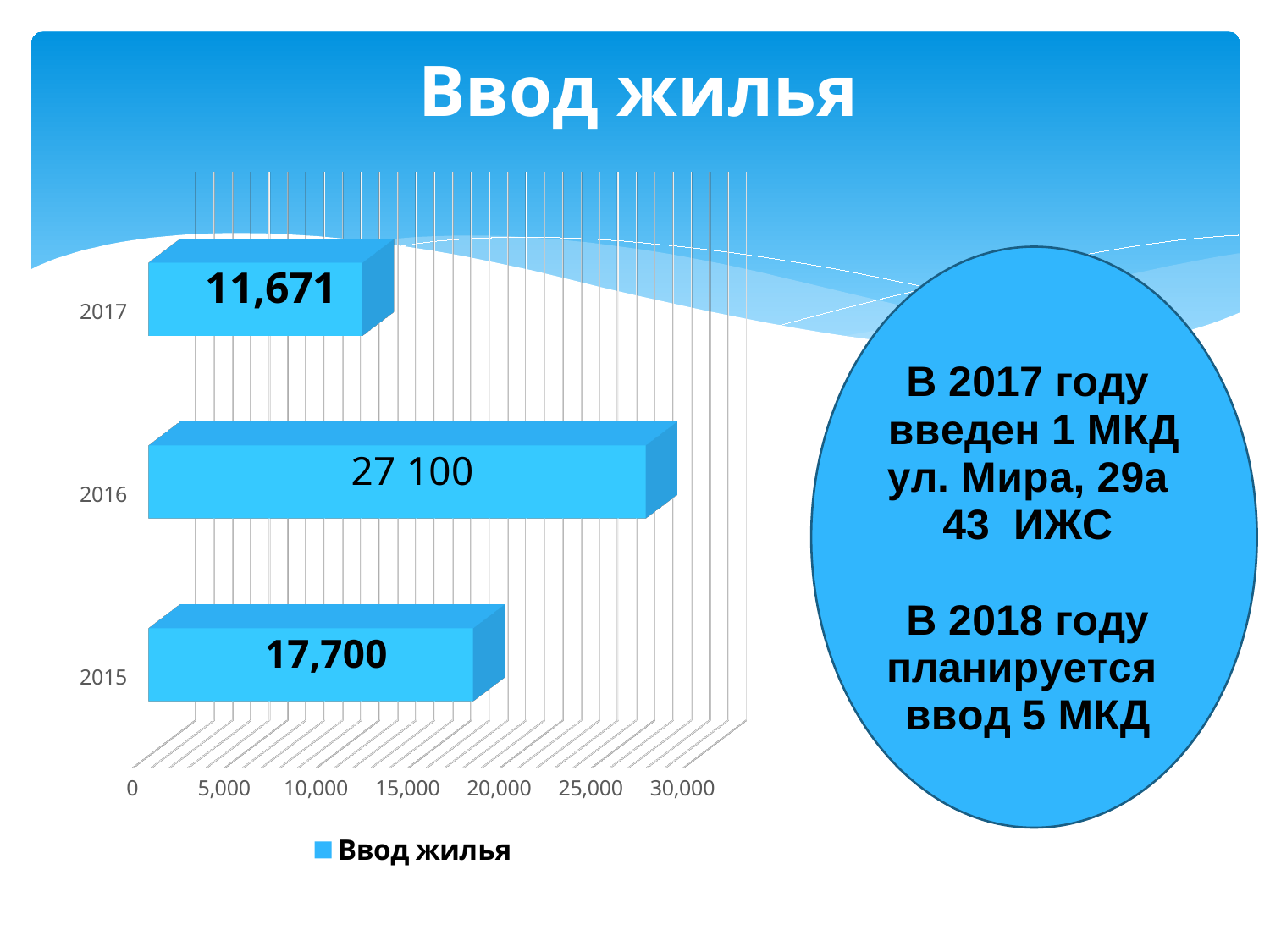
What is the value for 2017? 11,671 What is the value for 2016? 27 100 What is the difference between the values for 2015 and 2017? 6,029 Which year has the highest value? 2016 What kind of chart is shown on the slide? bar chart Is the value for 2016 greater or less than 25,000? greater How many years are shown in the chart? 3 Which year has the lowest value? 2017 What is the value for 2015? 17,700 Did the value rise or fall from 2016 to 2017? fall What is the title of the chart? Ввод жилья Which is larger, the value for 2015 or the value for 2017? 2015